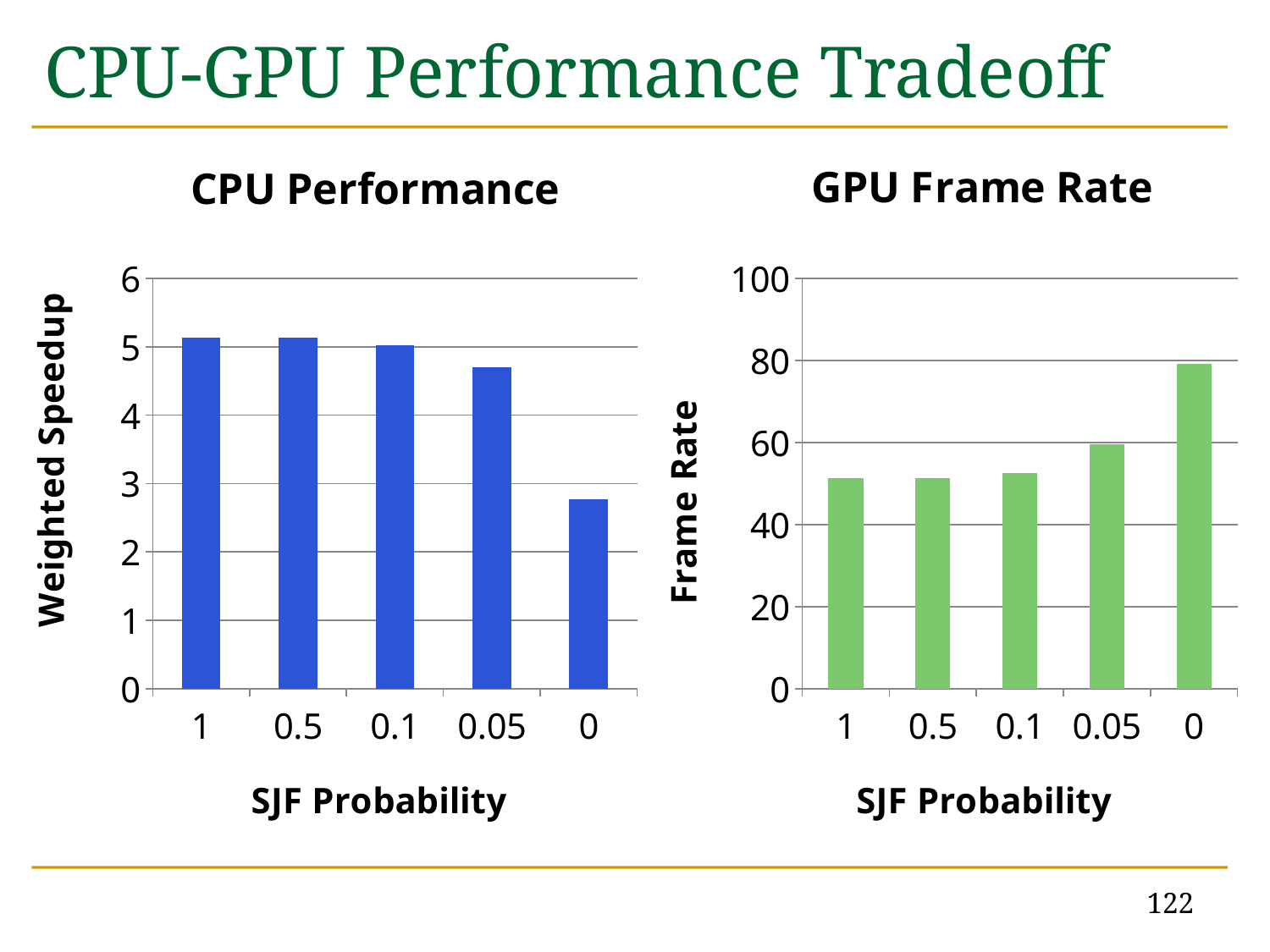
In the GPU Frame Rate chart, which SJF Probability has the highest frame rate? 0 In the GPU Frame Rate chart, is the frame rate for SJF Probability 0 greater or less than 60? greater In the CPU Performance chart, is the weighted speedup for SJF Probability 0 greater or less than 3? less In the CPU Performance chart, is the weighted speedup for SJF Probability 0.05 greater or less than 4? greater In the CPU Performance chart, which SJF Probability has the lowest weighted speedup? 0 In the GPU Frame Rate chart, which has the larger frame rate: SJF Probability 0.05 or 0? 0 In the CPU Performance chart, which has the larger weighted speedup: SJF Probability 0.05 or 0? 0.05 In the CPU Performance chart, do the weighted speedup values rise or fall from left to right along the x axis? fall What kind of chart is the GPU Frame Rate chart? bar chart How many SJF Probability categories are shown in the CPU Performance chart? 5 In the GPU Frame Rate chart, do the frame rate values rise or fall from left to right along the x axis? rise